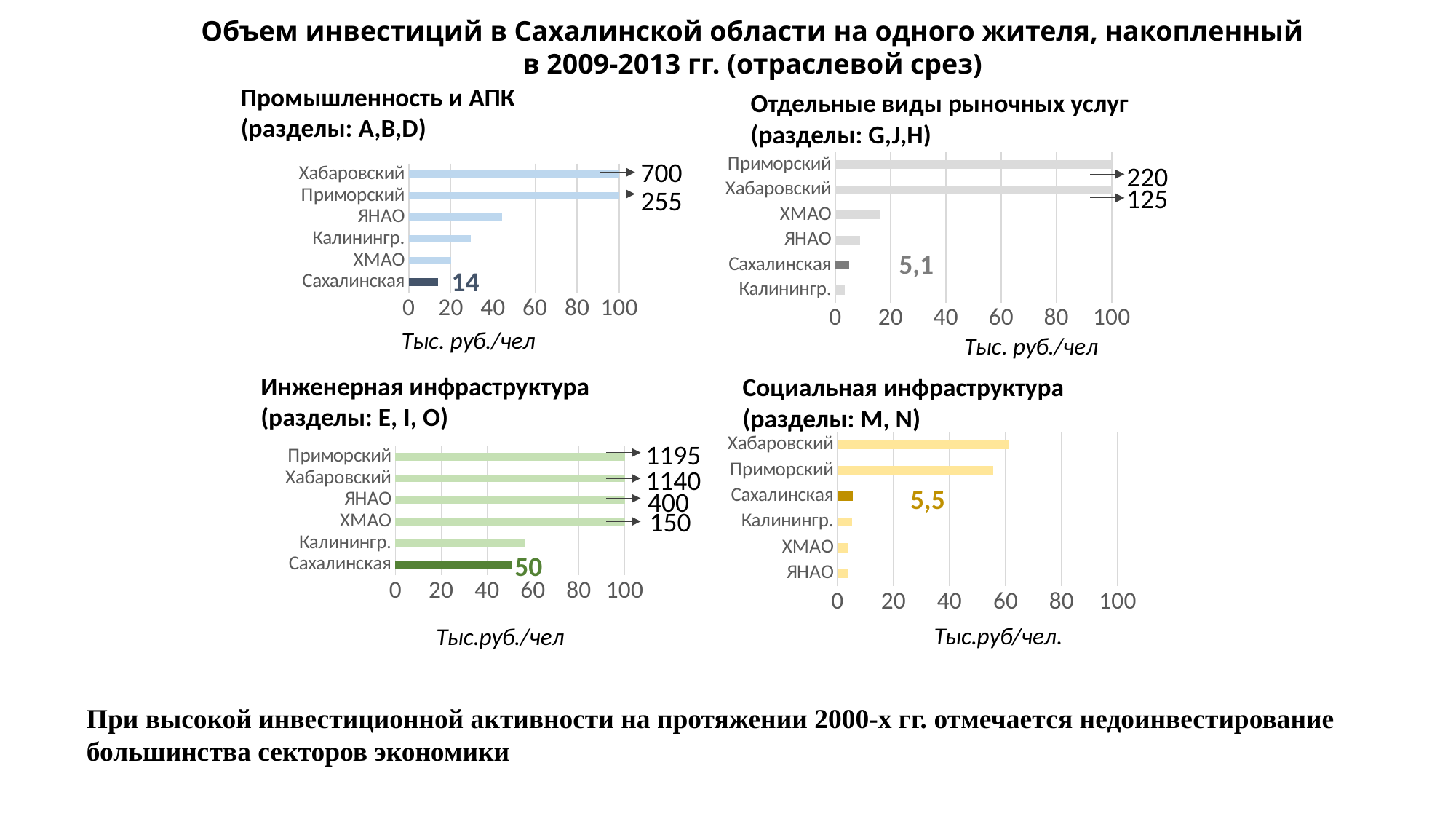
In the chart 'Инженерная инфраструктура (разделы: E, I, O)', what is the value for ЯНАО? 400 In the chart 'Инженерная инфраструктура (разделы: E, I, O)', which is larger, the value for ХМАО or the value for Сахалинская? ХМАО In the chart 'Социальная инфраструктура (разделы: M, N)', what is the value for Сахалинская? 5,5 In the chart 'Социальная инфраструктура (разделы: M, N)', is the value for Хабаровский greater or less than 40? greater In the chart 'Отдельные виды рыночных услуг (разделы: G,J,H)', which region has the highest value? Приморский In the chart 'Отдельные виды рыночных услуг (разделы: G,J,H)', what is the value for Сахалинская? 5,1 How many regions are shown in the chart 'Социальная инфраструктура (разделы: M, N)'? 6 In the chart 'Промышленность и АПК (разделы: A,B,D)', what is the value for Сахалинская? 14 In the chart 'Промышленность и АПК (разделы: A,B,D)', what is the value for Хабаровский? 700 In the chart 'Отдельные виды рыночных услуг (разделы: G,J,H)', is the value for ХМАО greater or less than 20? less In the chart 'Инженерная инфраструктура (разделы: E, I, O)', what is the difference between the values for Приморский and Хабаровский? 55 In the chart 'Промышленность и АПК (разделы: A,B,D)', what is the difference between the values for Хабаровский and Приморский? 445